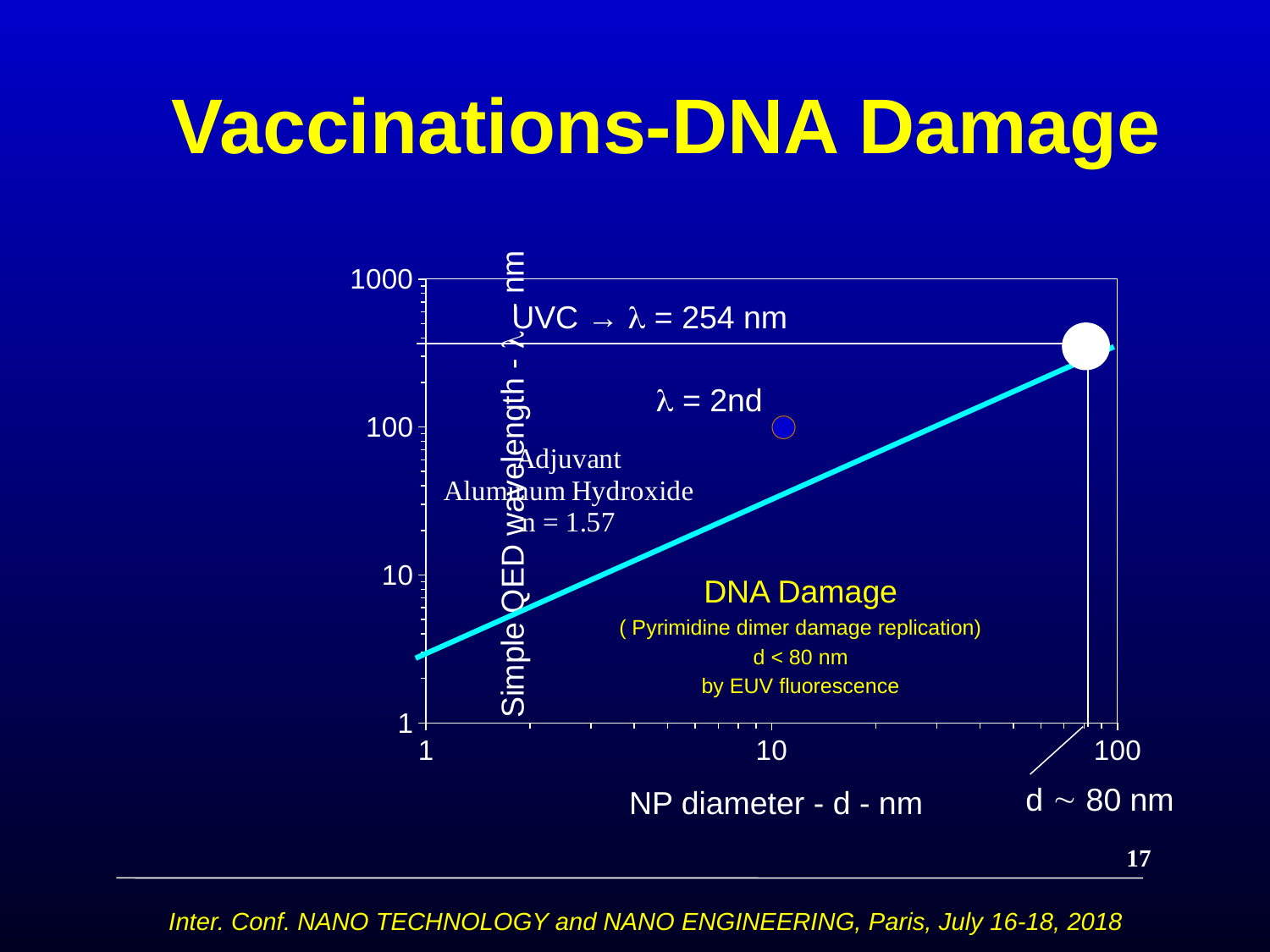
How many labelled tick values are on the x axis? 3 What refractive index n is given for the Aluminum Hydroxide adjuvant? 1.57 What kind of chart is shown on the slide? line chart What is the highest value labelled on the y axis? 1000 Is the Simple QED wavelength on the line at an NP diameter of 10 nm greater or less than 100 nm? less What is the label of the x axis? NP diameter - d - nm Below what NP diameter does the chart say DNA damage occurs by EUV fluorescence? d < 80 nm At what NP diameter does the chart mark the line reaching the UVC wavelength? d ~ 80 nm Is the Simple QED wavelength on the line at an NP diameter of 1 nm greater or less than 10 nm? less What is the title of the slide containing the chart? Vaccinations-DNA Damage What wavelength is given for UVC on the chart? 254 nm Does the Simple QED wavelength rise or fall as the NP diameter increases along the x axis? rise